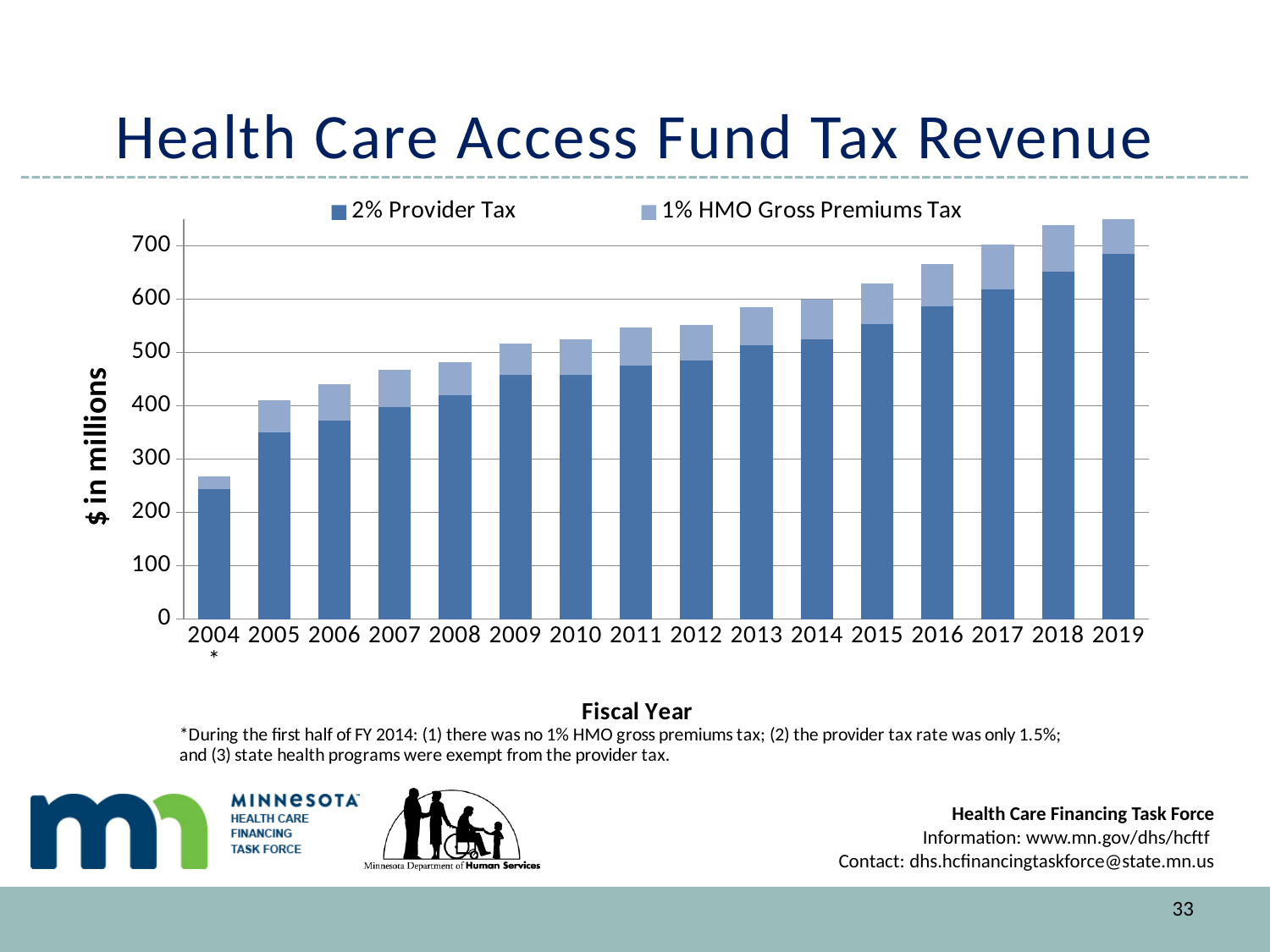
Which series is shown in the darker blue in the chart? 2% Provider Tax How many fiscal years are shown on the x axis of the chart? 16 How many series does the chart's legend list? 2 Is the 2% Provider Tax value for 2004 greater or less than 200? greater Which fiscal year has the highest total tax revenue? 2019 Do total tax revenues rise or fall from 2004 to 2019? Rise What is the label on the chart's vertical axis? $ in millions Which fiscal year has the lowest total tax revenue? 2004 Is the total revenue for 2004 greater or less than 300? less What kind of chart is shown on the slide? Stacked bar chart Is the total revenue for 2008 greater or less than 500? less